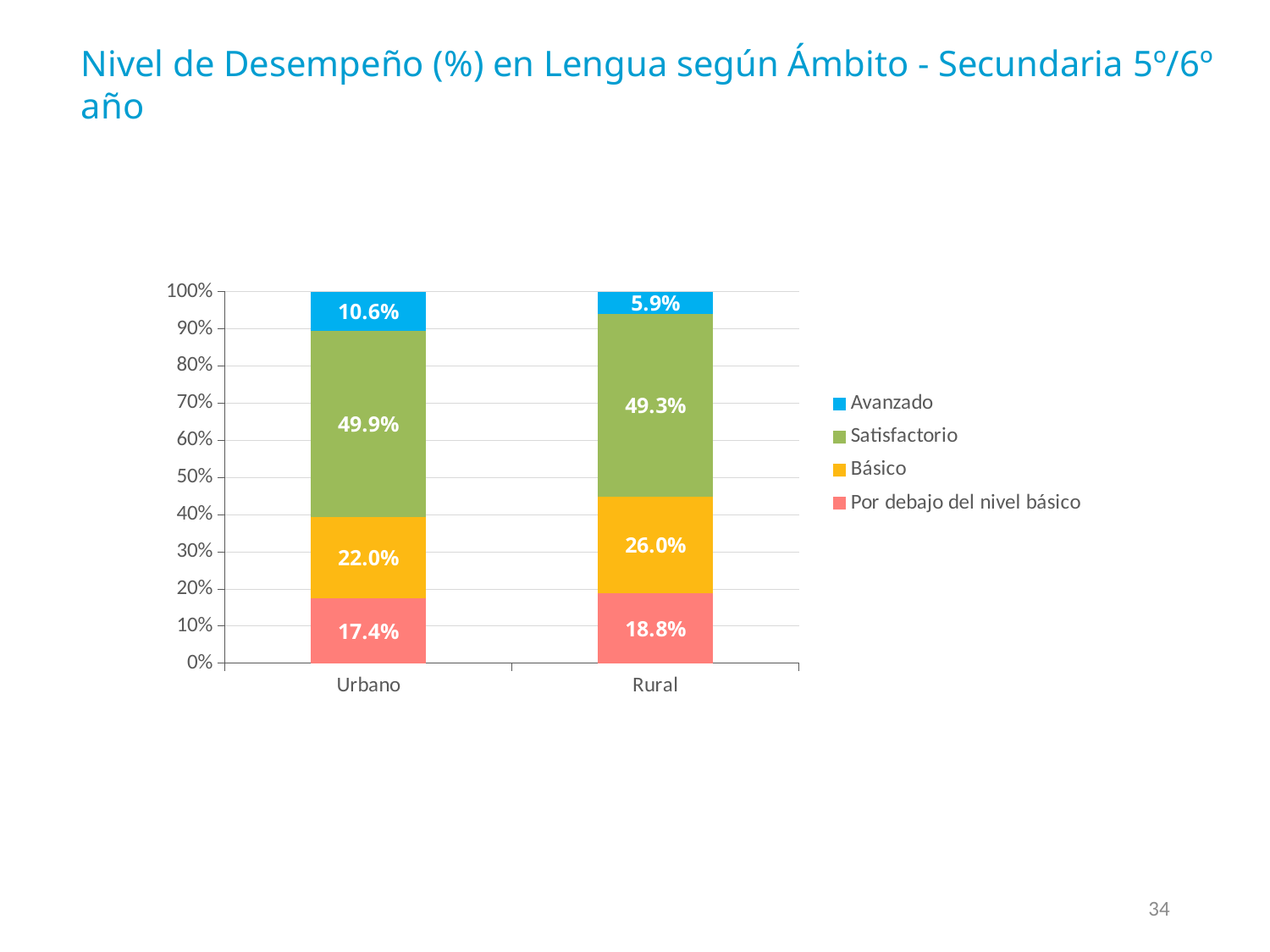
What is the difference between the Avanzado values for Urbano and Rural? 4.7% Which category has the higher Avanzado value, Urbano or Rural? Urbano Which series is shown in green in the legend? Satisfactorio What kind of chart is shown on the slide? Stacked bar chart What is the difference between the Básico values for Rural and Urbano? 4.0% What is the Básico value for Urbano? 22.0% Which category has the higher Básico value, Urbano or Rural? Rural What is the Por debajo del nivel básico value for Rural? 18.8% What is the Satisfactorio value for Rural? 49.3% What is the Avanzado value for Urbano? 10.6% How many categories are shown on the x axis? 2 How many series does the legend list? 4